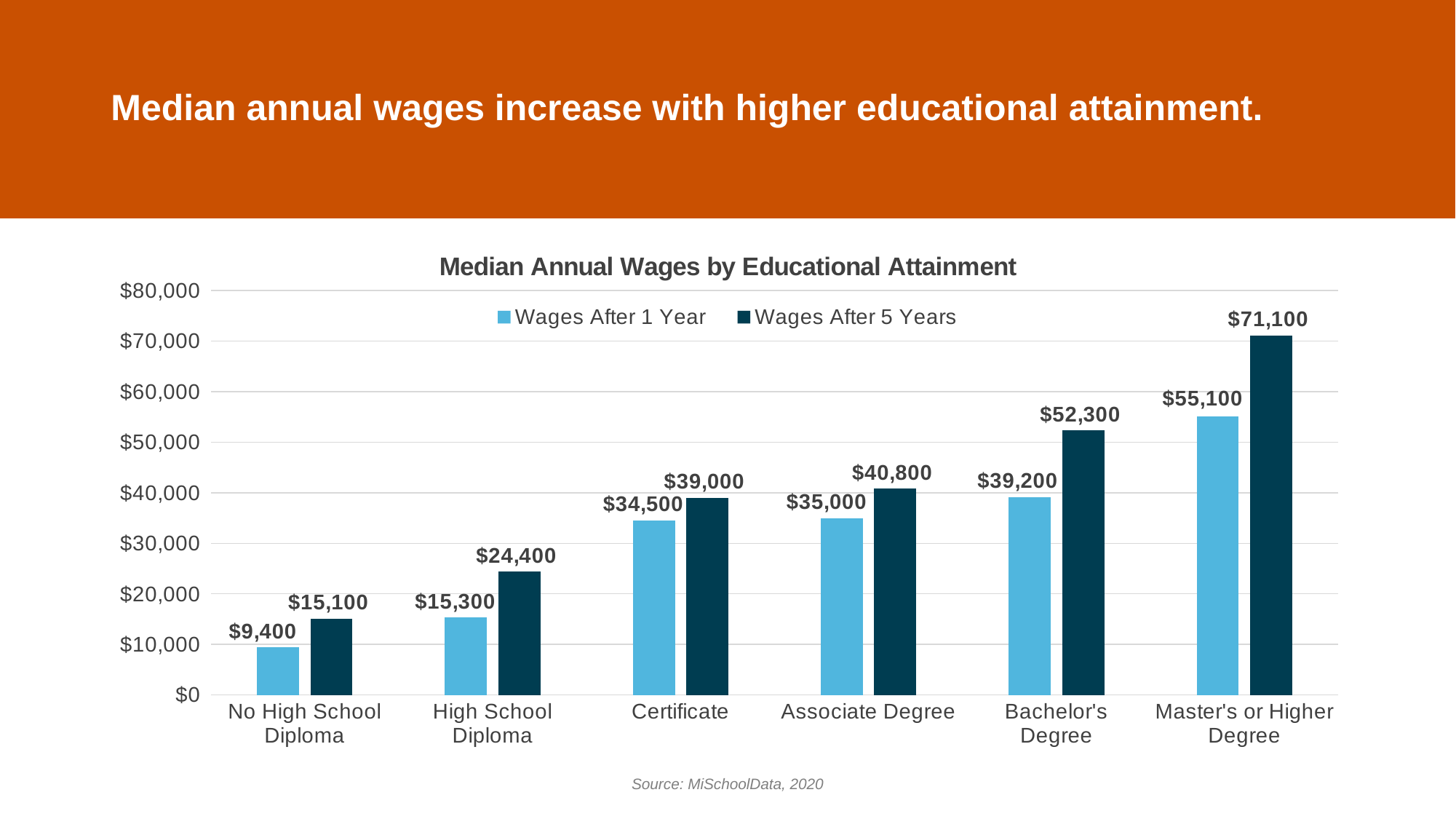
What is the value for Wages After 1 Year for No High School Diploma? $9,400 What kind of chart is shown on the slide? bar chart What is the difference between Wages After 5 Years and Wages After 1 Year for Master's or Higher Degree? $16,000 What is the difference between Wages After 5 Years for High School Diploma and No High School Diploma? $9,300 What is the value for Wages After 5 Years for Bachelor's Degree? $52,300 What is the value for Wages After 1 Year for Certificate? $34,500 Is the value for Wages After 5 Years for Associate Degree greater or less than $50,000? less Which category has the lowest value for Wages After 1 Year? No High School Diploma How many educational attainment categories are shown on the x axis? 6 How many series does the legend list? 2 Which is larger: Wages After 1 Year for Bachelor's Degree or Wages After 5 Years for Certificate? Wages After 1 Year for Bachelor's Degree Which category has the highest value for Wages After 5 Years? Master's or Higher Degree